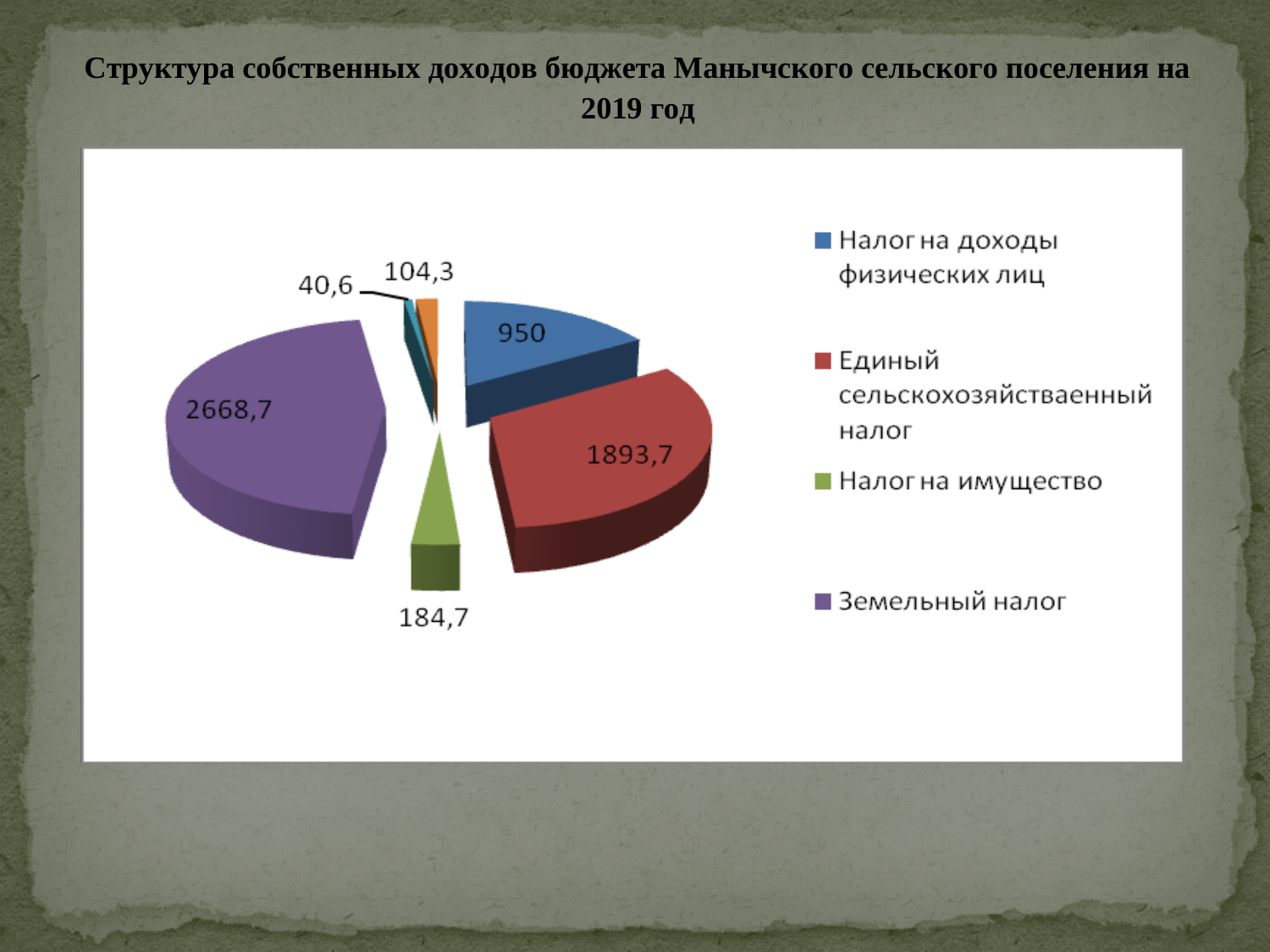
What kind of chart is shown on the slide? Pie chart What is the difference between Единый сельскохозяйственный налог and Налог на доходы физических лиц? 943,7 What is the value for Земельный налог? 2668,7 What is the value for Налог на доходы физических лиц? 950 How many entries does the legend list? 4 Which category has the largest slice of the pie? Земельный налог What is the difference between Земельный налог and Единый сельскохозяйственный налог? 775 Which is larger: Налог на доходы физических лиц or Налог на имущество? Налог на доходы физических лиц What is the value for Налог на имущество? 184,7 How many slices does the pie chart have? 6 What is the value for Единый сельскохозяйственный налог? 1893,7 Which of the four legend categories has the smallest value? Налог на имущество